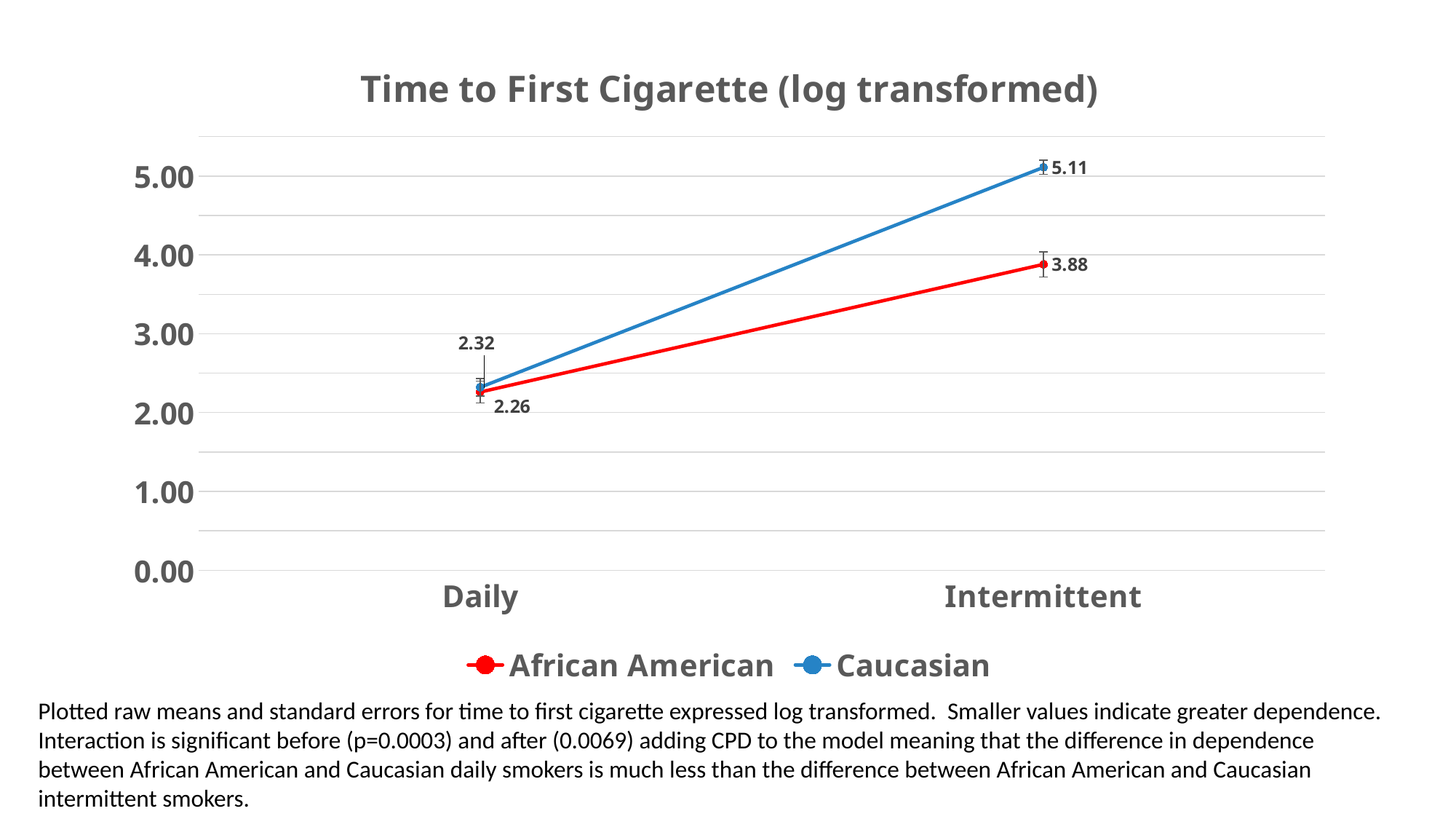
What is the difference between the Caucasian and African American values at Intermittent? 1.23 What is the difference between the Caucasian and African American values at Daily? 0.06 What is the value for Caucasian at Intermittent? 5.11 What is the value for Caucasian at Daily? 2.32 At Intermittent, which series has the larger value, African American or Caucasian? Caucasian How many series does the legend list? 2 What is the value for African American at Daily? 2.26 Do the values rise or fall from Daily to Intermittent? rise Is the value for African American at Intermittent greater or less than 4.00? less Which series has the highest value on the chart? Caucasian What kind of chart is this? line chart What is the value for African American at Intermittent? 3.88